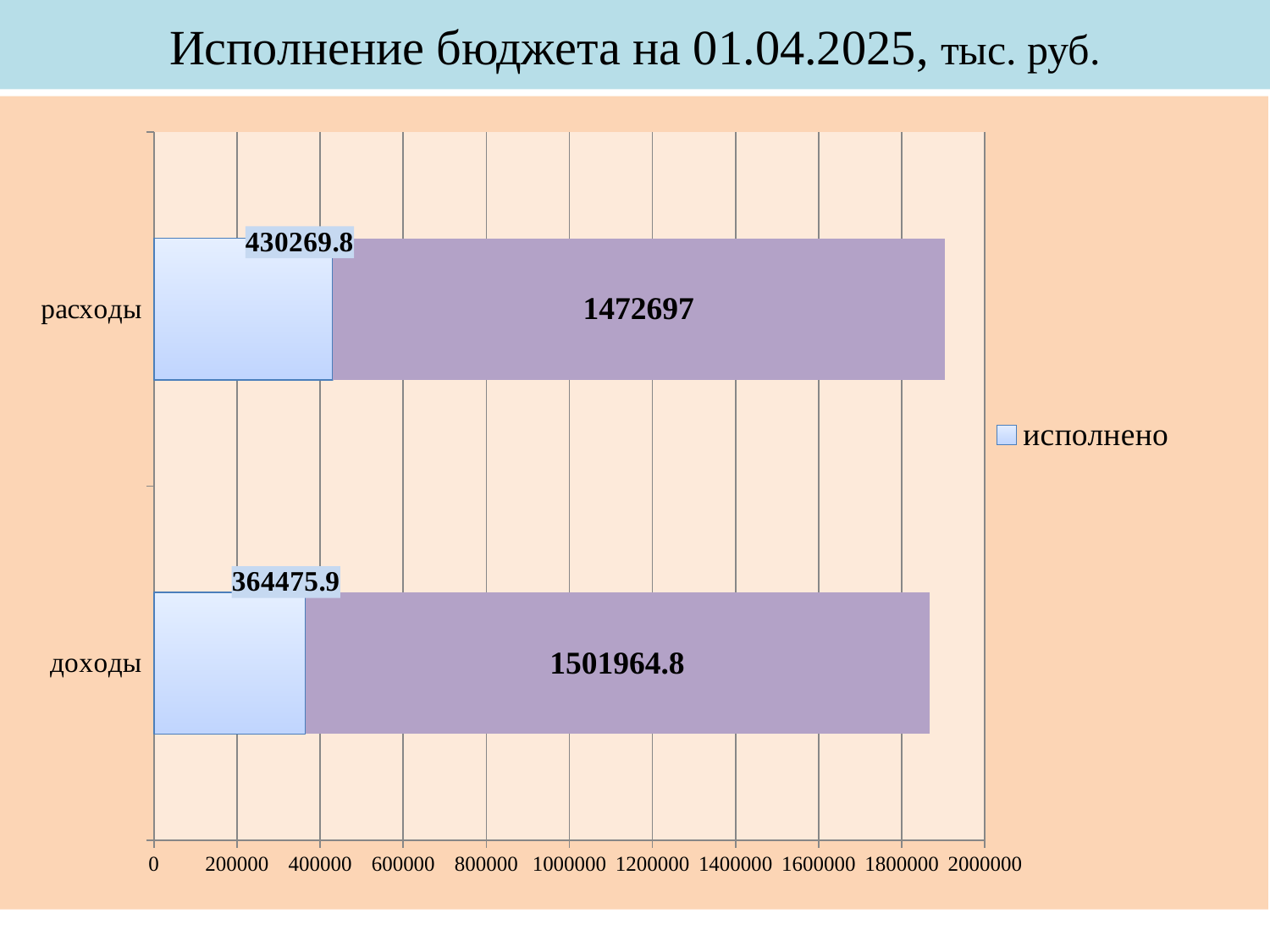
What is the total of the stacked bar for "доходы"? 1866440.7 How many categories are shown on the chart? 2 Which category has the larger "исполнено" value, "расходы" or "доходы"? расходы What is the value of the "исполнено" segment for "расходы"? 430269.8 What value is printed on the purple segment of the "расходы" bar? 1472697 What is the total of the stacked bar for "расходы"? 1902966.8 What type of chart is shown on the slide? Bar chart What is the value of the "исполнено" segment for "доходы"? 364475.9 Is the "исполнено" value for "доходы" greater or less than 400000? less What is the difference between the "исполнено" values for "расходы" and "доходы"? 65793.9 What is the difference between the purple segment values for "доходы" and "расходы"? 29267.8 What value is printed on the purple segment of the "доходы" bar? 1501964.8